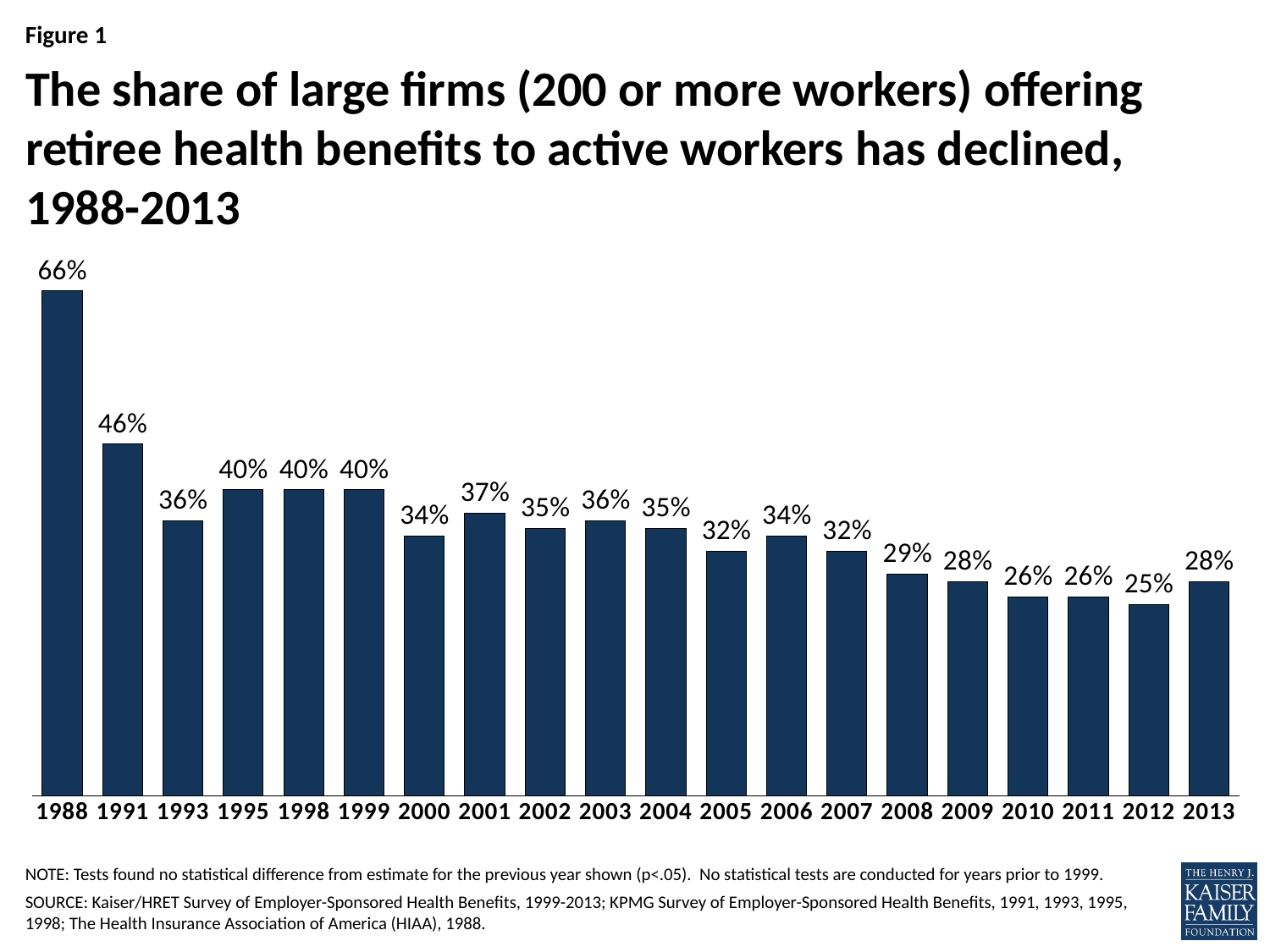
What is the value shown for 2013? 28% Which year has the lowest value? 2012 What is the difference between the values for 1988 and 2013? 38 percentage points What kind of chart is this? Bar chart Which is larger, the value for 2006 or the value for 2007? 2006 Overall, do the values rise or fall from 1988 to 2013? Fall What figure number is given for this chart? Figure 1 What is the difference between the values for 1991 and 1993? 10 percentage points What share of large firms offered retiree health benefits in 1988? 66% Which year has the highest value? 1988 How many years are shown on the x axis? 20 What is the value shown for 2001? 37%